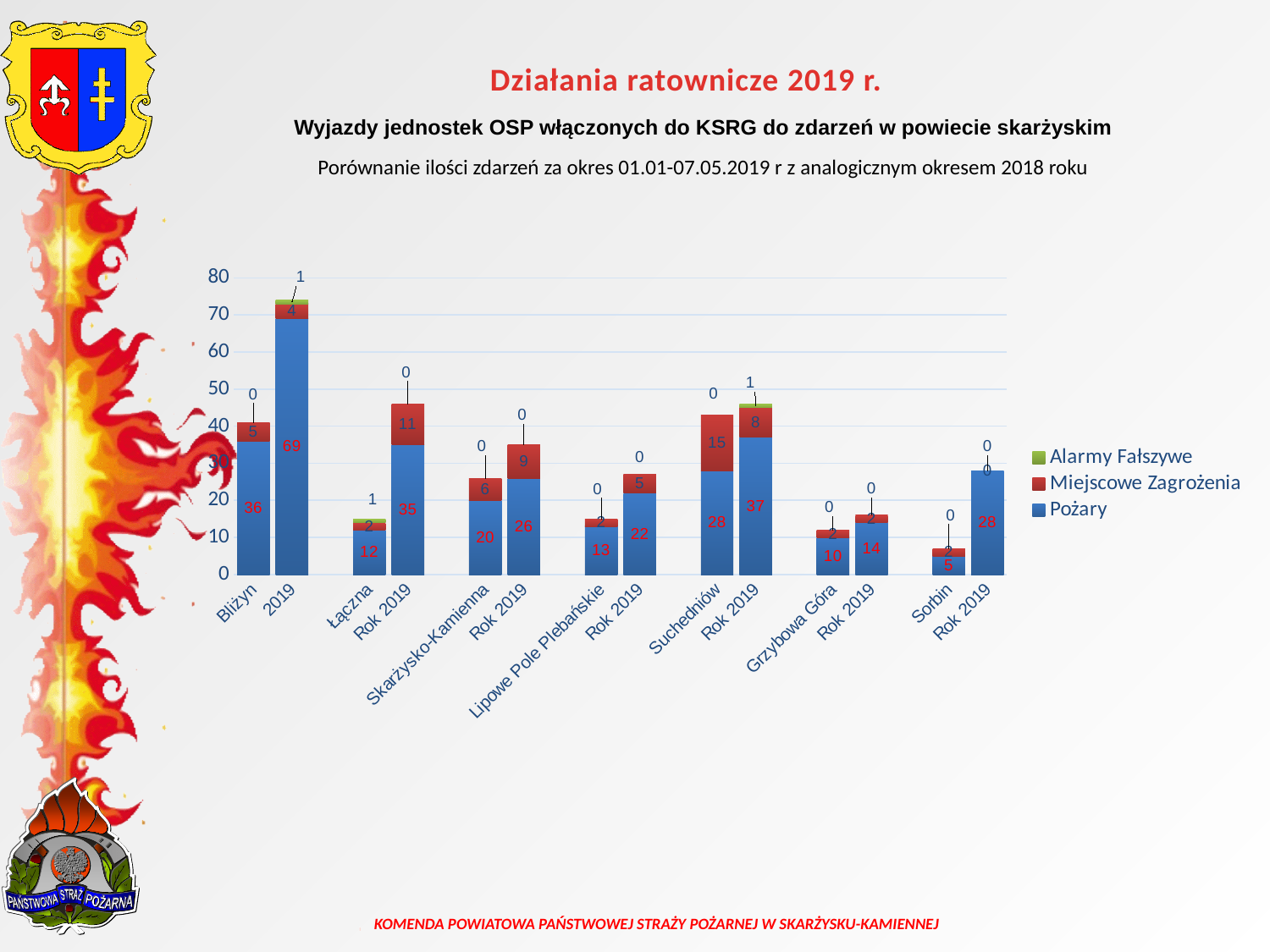
What is the Alarmy Fałszywe value for Łączna? 1 Which bar has the lowest Pożary value? Sorbin What is the difference between the Pożary values for Skarżysko-Kamienna and its Rok 2019 bar? 6 Which is larger, the Miejscowe Zagrożenia value for Suchedniów or for the Rok 2019 bar next to Łączna? Suchedniów Which bar has the highest Pożary value? 2019 (Bliżyn) What is the Pożary value for Bliżyn? 36 What is the Pożary value for the 2019 bar next to Bliżyn? 69 Which series is shown in green in the legend? Alarmy Fałszywe What type of chart is shown on the slide? stacked bar chart What is the Miejscowe Zagrożenia value for Suchedniów? 15 What is the total of the stacked bar for Suchedniów? 43 How many series does the chart legend list? 3